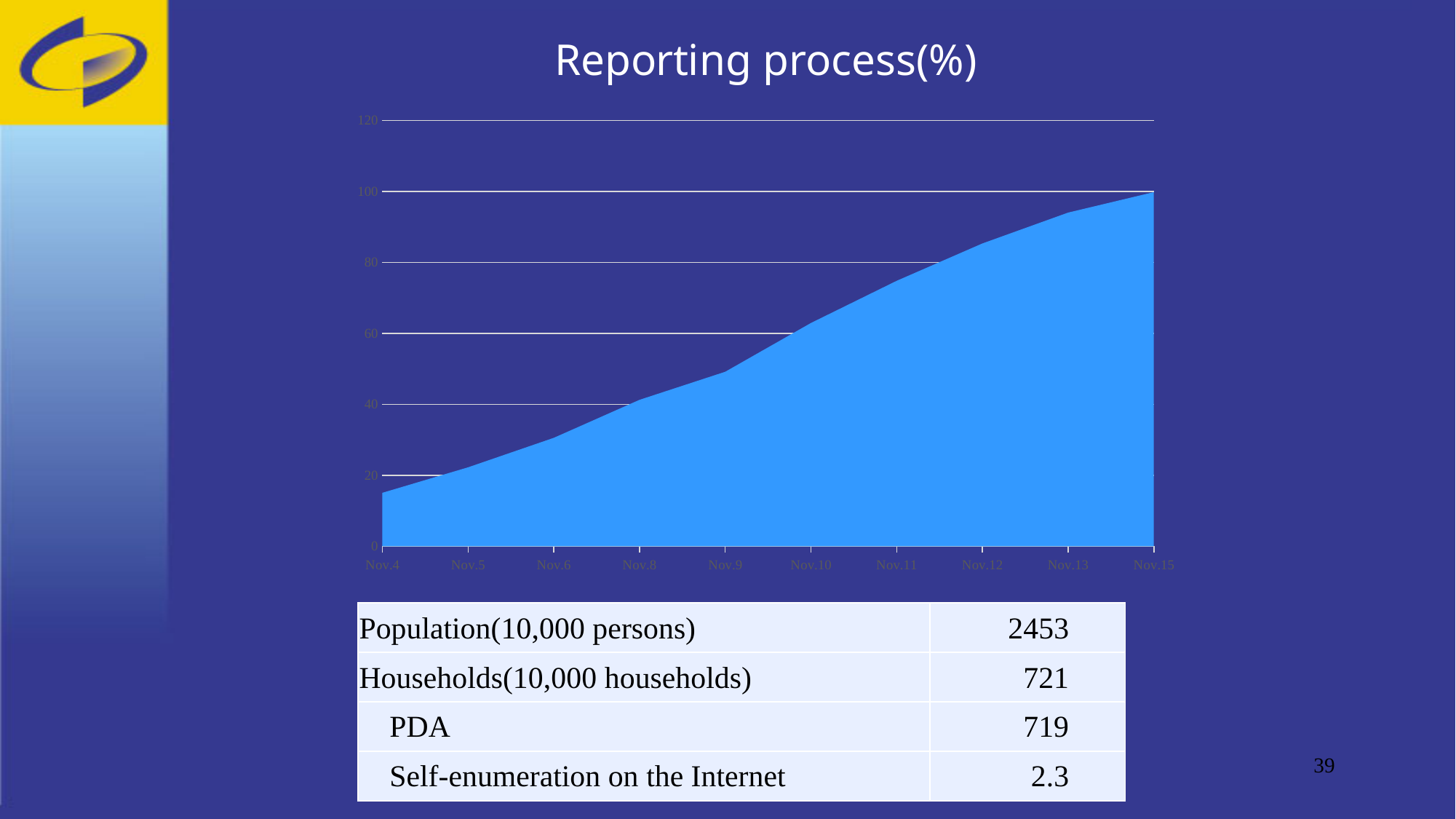
What is the title of the chart? Reporting process(%) How many dates are shown along the x axis of the chart? 10 Is the value for Nov.11 greater or less than 60? greater Which is larger, the value for Nov.13 or the value for Nov.6? Nov.13 Is the value for Nov.13 greater or less than 80? greater What kind of chart is shown on the slide? area chart Is the value for Nov.4 greater or less than 20? less Do the values rise or fall from Nov.4 to Nov.15? rise Which date has the lowest value in the chart? Nov.4 Which date has the highest value in the chart? Nov.15